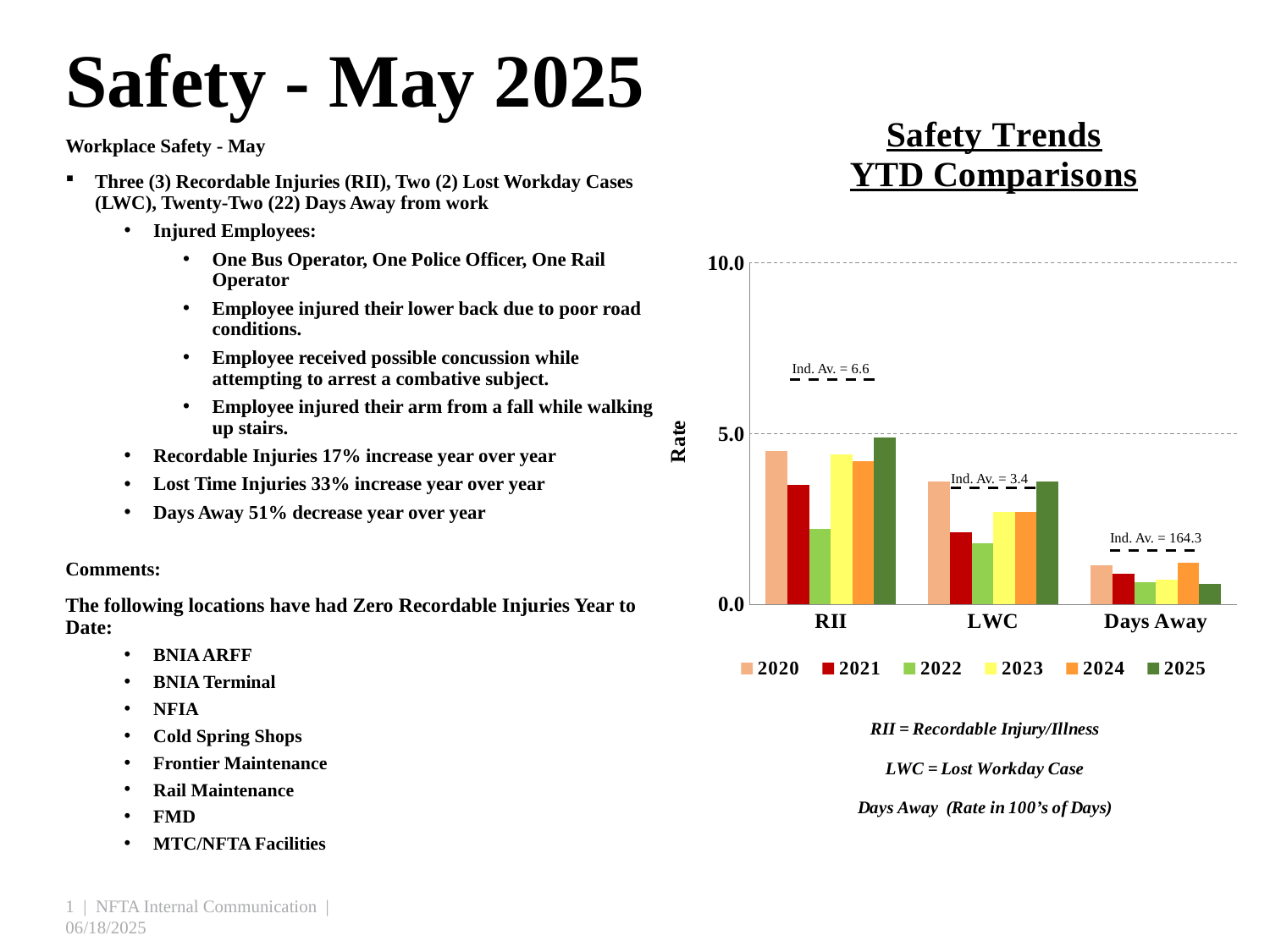
What is the industry average shown for LWC? 3.4 Which is larger, the RII value for 2021 or the RII value for 2022? 2021 Which year has the lowest LWC rate? 2022 What is the title of the chart? Safety Trends YTD Comparisons How many categories are shown on the x axis? 3 Which is larger, the 2020 value for RII or the 2020 value for LWC? RII Is the LWC value for 2022 greater or less than 5.0? less Which year has the highest RII rate? 2025 Which year has the lowest RII rate? 2022 Is the RII value for 2020 greater or less than 5.0? less What kind of chart is shown on the slide? bar chart How many series does the legend list? 6